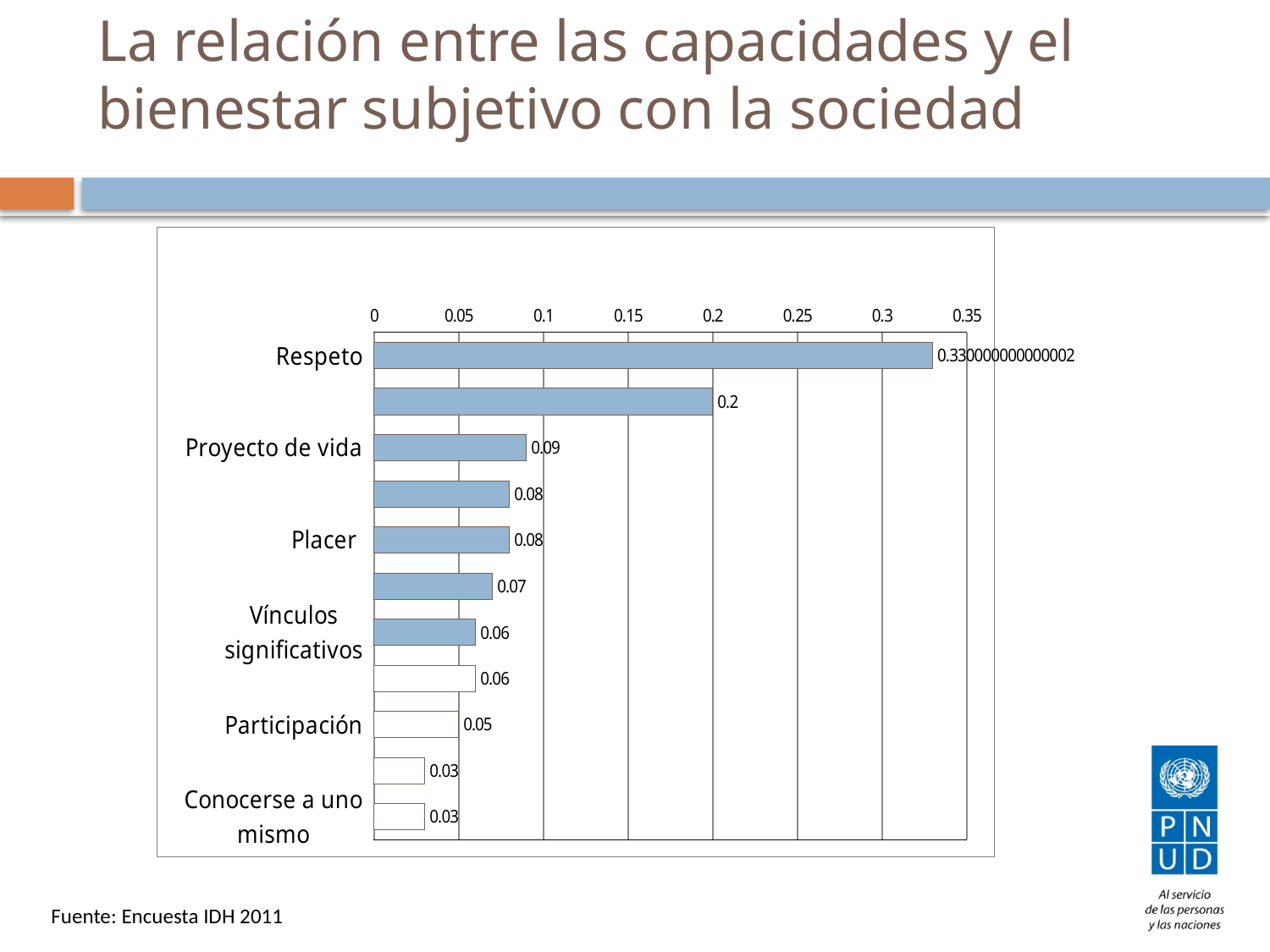
Which has a larger value, Proyecto de vida or Placer? Proyecto de vida What is the value for Respeto? 0.330000000000002 What is the value for Conocerse a uno mismo? 0.03 How many bars are plotted in the chart? 11 What is the value for Placer? 0.08 Which category has the highest value? Respeto What is the value for Participación? 0.05 What is the difference between the values for Proyecto de vida and Participación? 0.04 What type of chart is shown on the slide? bar chart What is the value for Vínculos significativos? 0.06 What is the value for Proyecto de vida? 0.09 Is the value for Respeto greater or less than 0.3? greater